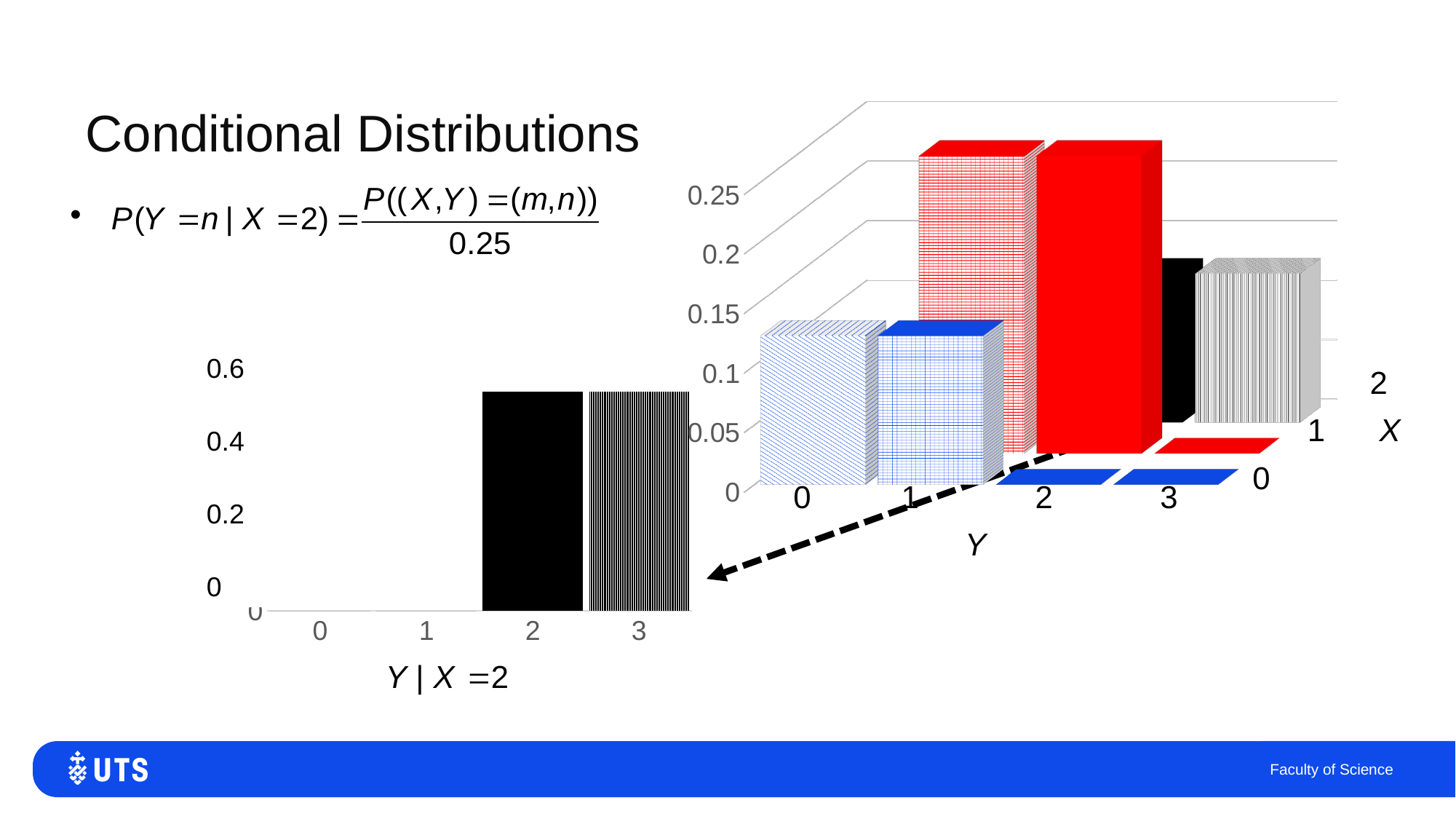
What kind of chart is the chart on the right of the slide? 3D bar chart In the left chart labelled Y | X = 2, which is larger, the value for category 1 or the value for category 3? 3 In the left chart labelled Y | X = 2, how many categories are shown on the x axis? 4 In the chart on the right, what is the highest value shown on the vertical axis? 0.25 In the left chart labelled Y | X = 2, what is the label shown beneath the x axis? Y | X = 2 In the left chart labelled Y | X = 2, which is larger, the value for category 0 or the value for category 2? 2 What kind of chart is the left chart labelled Y | X = 2? bar chart In the left chart labelled Y | X = 2, is the value for category 3 greater or less than 0.6? less In the left chart labelled Y | X = 2, is the value for category 2 greater or less than 0.2? greater In the left chart labelled Y | X = 2, is the value for category 2 greater or less than 0.4? greater In the chart on the right, how many categories are shown along the Y axis? 4